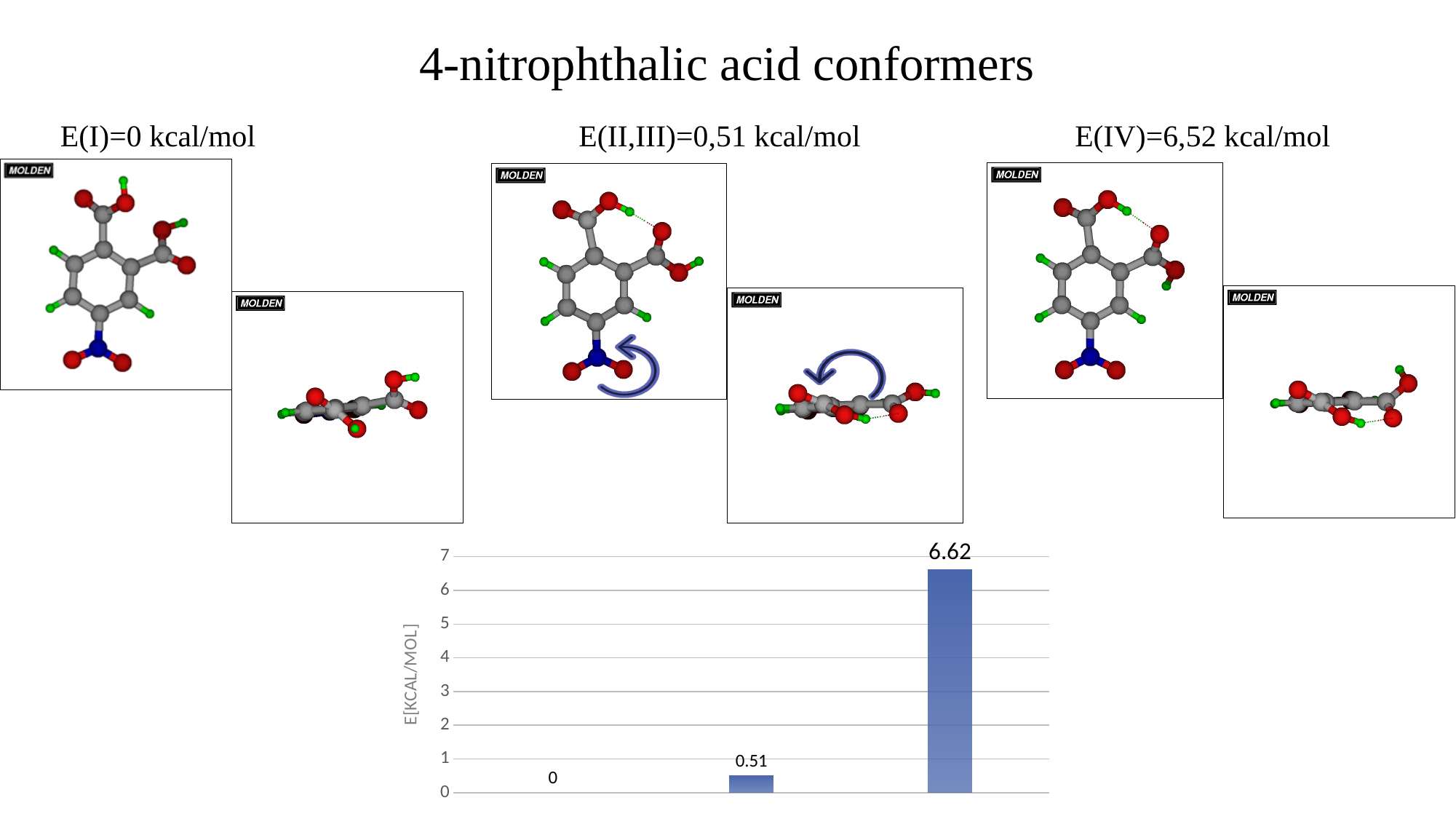
Which is larger in the chart, the value of the second bar or the value of the third bar? the third bar Do the bar values rise or fall from left to right in the chart? rise What is the label on the vertical axis of the chart? E[KCAL/MOL] What is the value shown on the data label of the second (middle) bar in the chart? 0.51 What is the difference between the values of the third bar and the second bar in the chart? 6.11 Is the value of the third bar in the chart greater or less than 6? greater Which bar in the chart has the highest value: the first, second or third? third What is the value shown on the data label of the first (leftmost) bar in the chart? 0 How many bars are plotted in the chart? 3 Which bar in the chart has the lowest value: the first, second or third? first What is the value shown on the data label of the third (rightmost) bar in the chart? 6.62 What kind of chart is shown at the bottom of the slide? bar chart